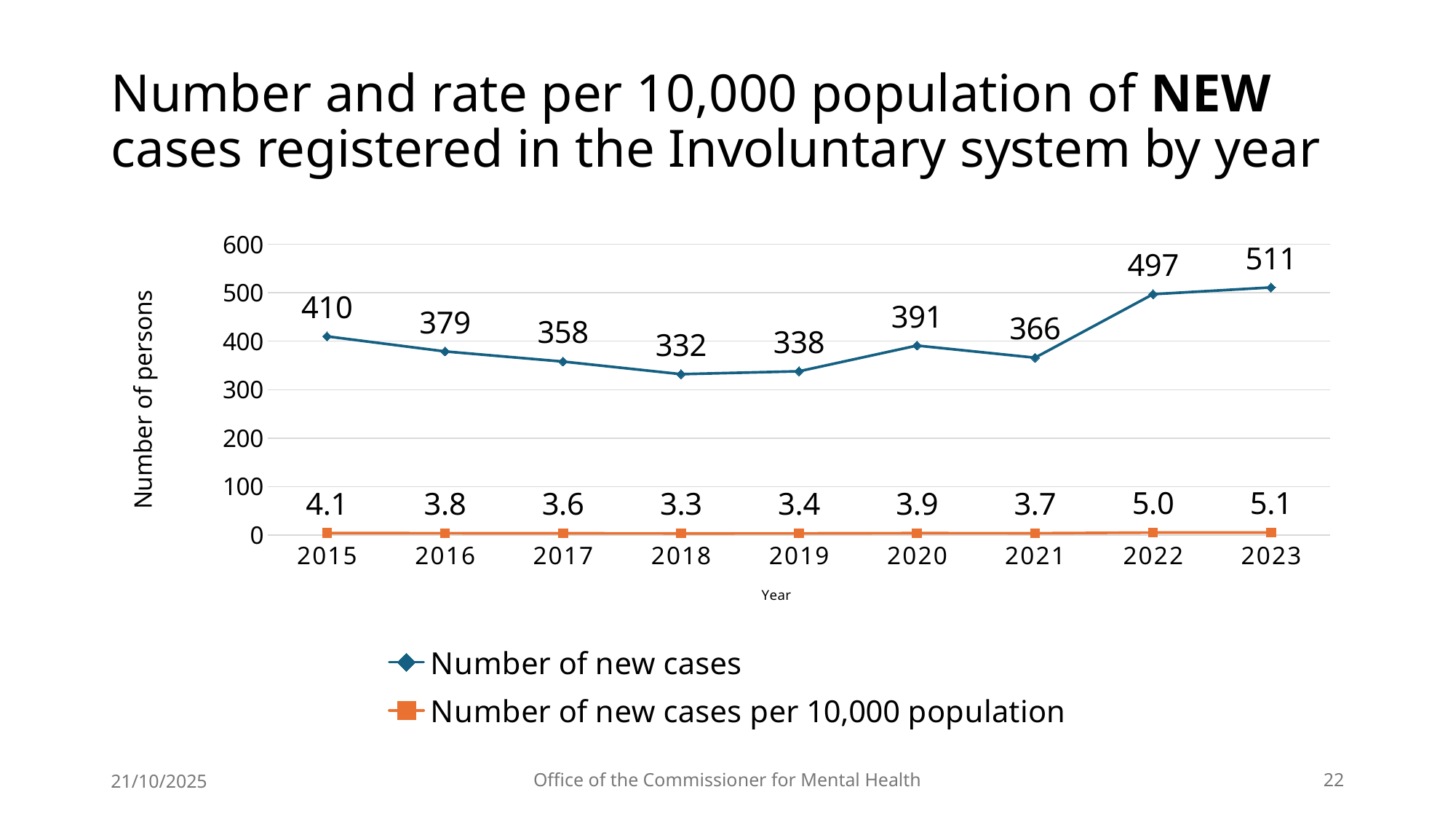
What was the number of new cases per 10,000 population in 2023? 5.1 Is the number of new cases in 2022 greater or less than 400? greater How many series does the legend list? 2 What kind of chart is shown on the slide? Line chart Which year had more new cases, 2016 or 2021? 2016 Which year had the lowest number of new cases per 10,000 population? 2018 What was the number of new cases in 2020? 391 How many years are shown on the x axis? 9 What was the number of new cases in 2018? 332 What is the difference in the number of new cases between 2023 and 2015? 101 Which year had the highest number of new cases? 2023 What is the label of the y axis? Number of persons